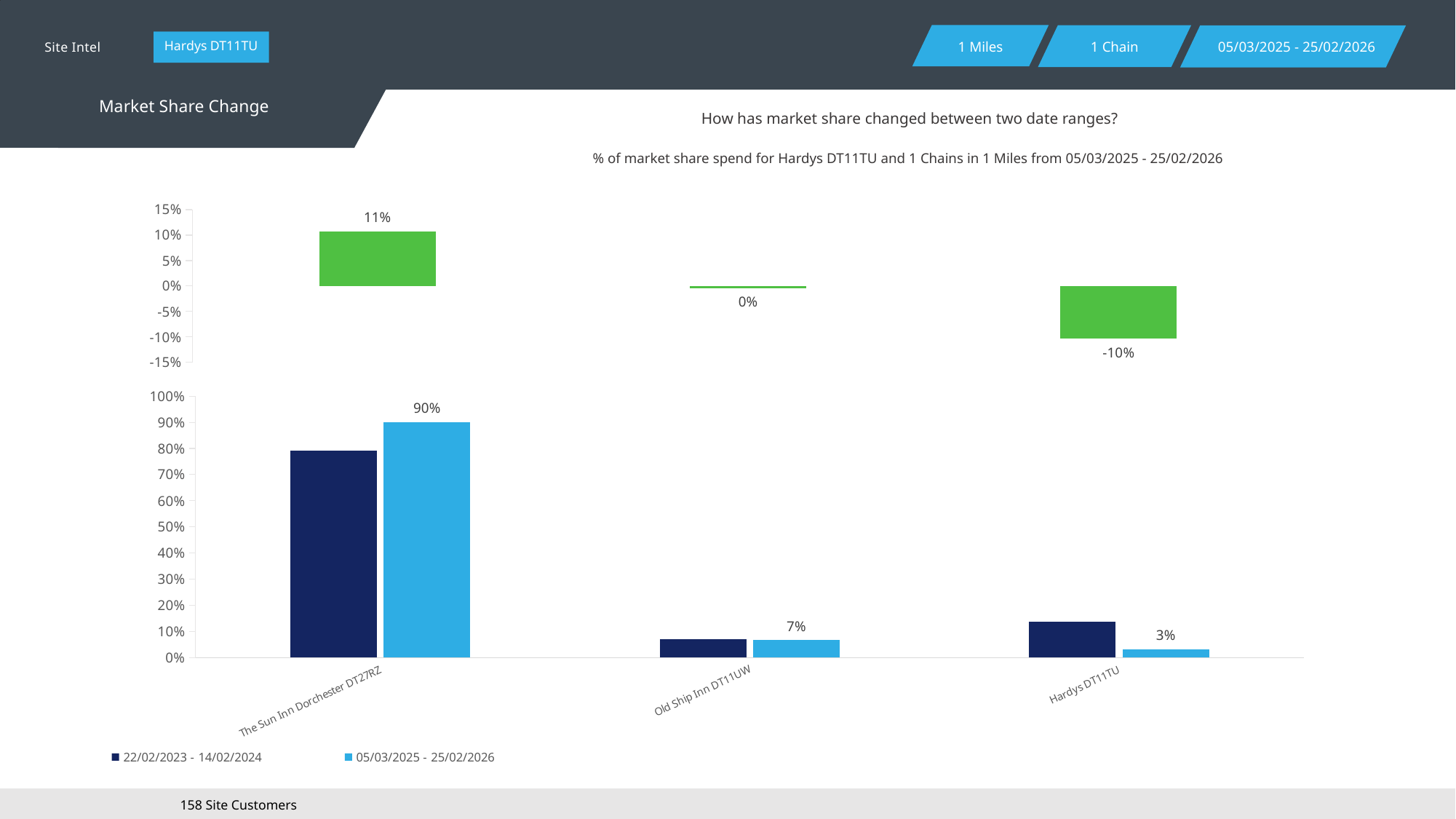
In the top chart showing market share change, what is the value for The Sun Inn Dorchester DT27RZ? 11% In the bottom market share chart, what is the difference between the 05/03/2025 - 25/02/2026 values for The Sun Inn Dorchester DT27RZ and Old Ship Inn DT11UW? 83% In the bottom market share chart, what is the value for Hardys DT11TU in the 05/03/2025 - 25/02/2026 series? 3% In the bottom market share chart, is the 22/02/2023 - 14/02/2024 value for Hardys DT11TU greater or less than 20%? less In the bottom market share chart, what is the value for The Sun Inn Dorchester DT27RZ in the 05/03/2025 - 25/02/2026 series? 90% In the top chart showing market share change, what is the value for Hardys DT11TU? -10% In the bottom market share chart, which is larger for Hardys DT11TU: the 22/02/2023 - 14/02/2024 value or the 05/03/2025 - 25/02/2026 value? 22/02/2023 - 14/02/2024 In the top chart showing market share change, which category has the lowest value? Hardys DT11TU In the bottom market share chart, is the 22/02/2023 - 14/02/2024 value for The Sun Inn Dorchester DT27RZ greater or less than 70%? greater How many series does the legend of the bottom market share chart list? 2 In the top chart showing market share change, what is the value for Old Ship Inn DT11UW? 0% What kind of chart is the bottom market share chart? bar chart